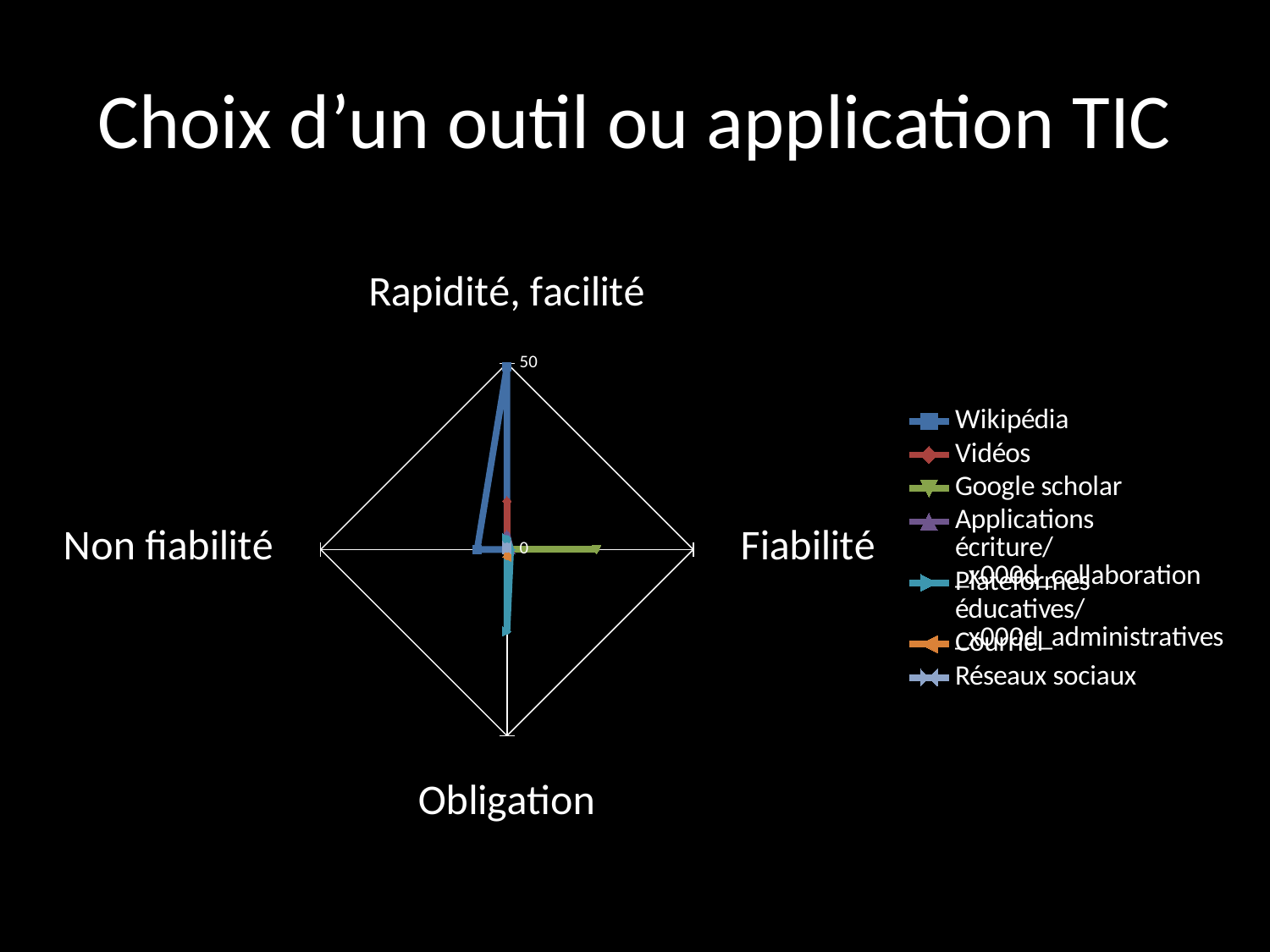
Which series extends furthest along the Fiabilité axis? Google scholar Which series extends furthest along the Non fiabilité axis? Wikipédia How many series does the legend list? 7 Which series reaches the highest value on the Rapidité, facilité axis? Wikipédia What is the title of the slide containing the chart? Choix d’un outil ou application TIC What kind of chart is shown on the slide? Radar chart On the Rapidité, facilité axis, which is larger: Wikipédia or Vidéos? Wikipédia How many axes (categories) does the radar chart have? 4 What is the maximum value shown on the chart's radial axis? 50 Which axis label appears at the bottom of the radar chart? Obligation